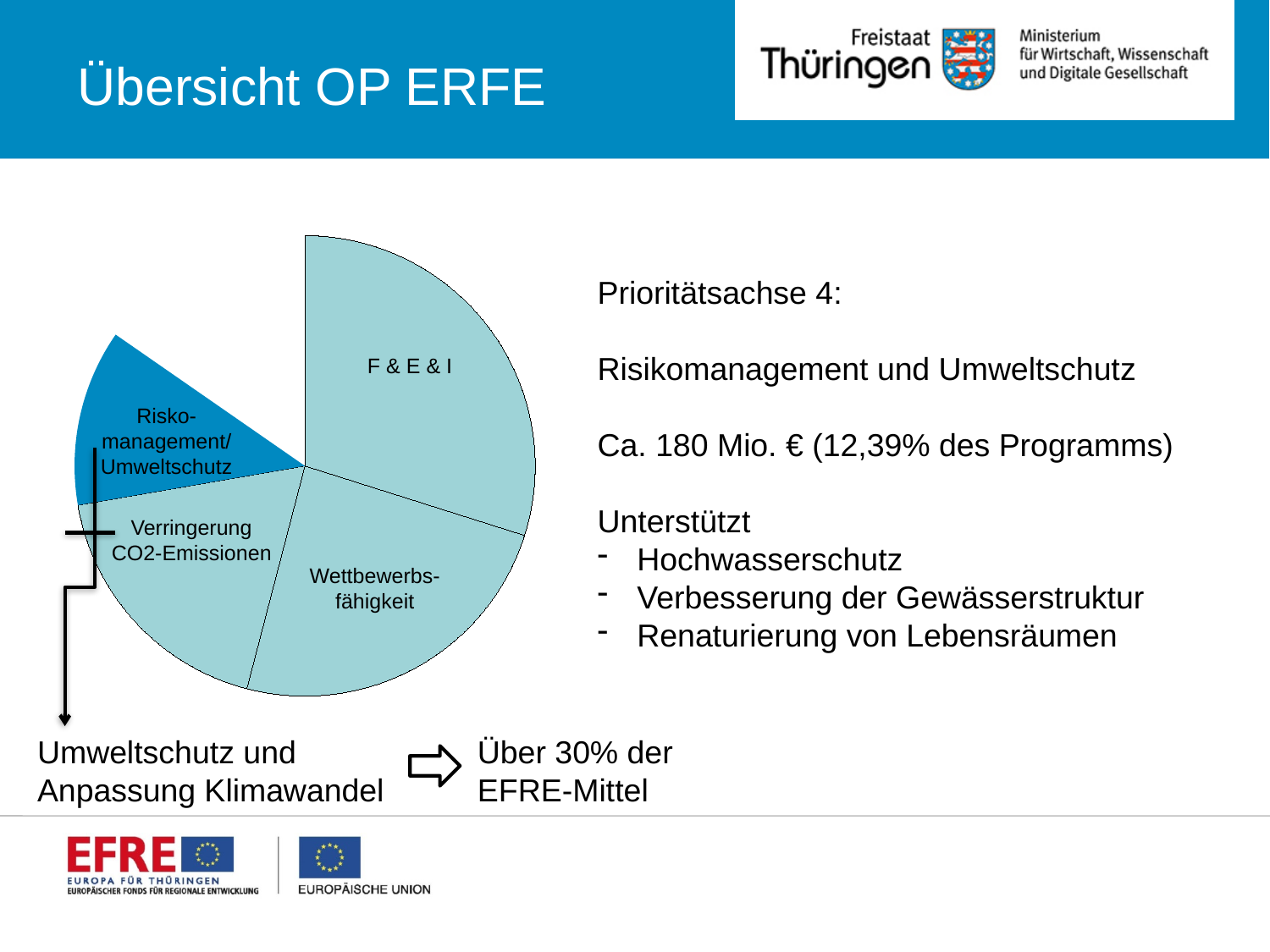
What kind of chart is shown on the slide? pie chart According to the slide, what share of the programme does the Risikomanagement/Umweltschutz slice represent? 12,39% Which slice of the pie chart is labelled at the top right? F & E & I Which slice is larger, Verringerung CO2-Emissionen or Risikomanagement/Umweltschutz? Verringerung CO2-Emissionen Which slice of the pie chart is highlighted in a darker blue colour? Risikomanagement/Umweltschutz Which slice is larger, F & E & I or Wettbewerbsfähigkeit? F & E & I Which slice of the pie chart is the smallest? Risikomanagement/Umweltschutz How many slices does the pie chart have? 4 Which slice of the pie chart is the largest? F & E & I